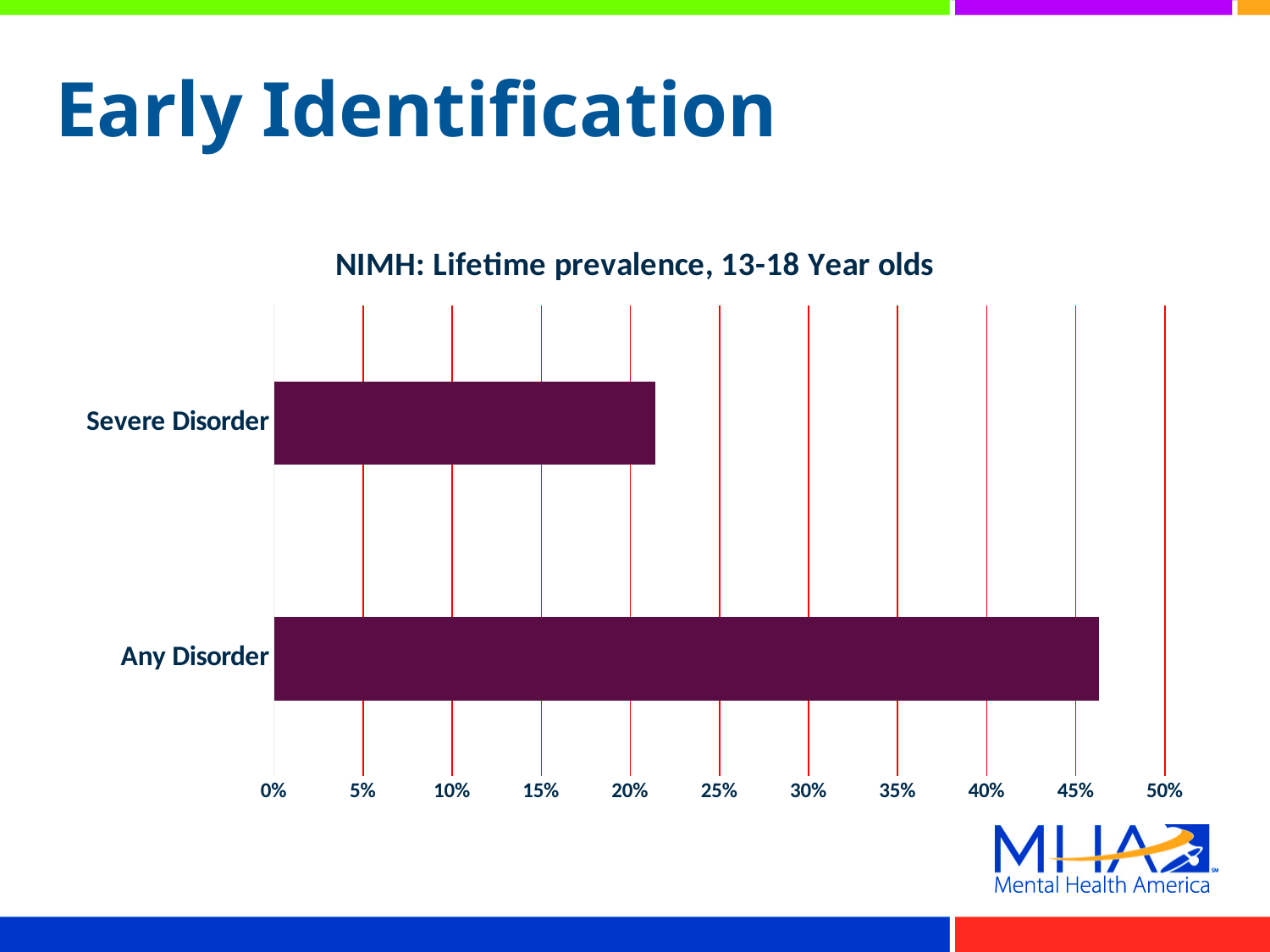
What is the title of the chart? NIMH: Lifetime prevalence, 13-18 Year olds Is the value for Severe Disorder greater or less than 20%? greater Which category has the highest value? Any Disorder Which is larger, the value for Any Disorder or the value for Severe Disorder? Any Disorder Which category has the lowest value? Severe Disorder Is the value for Severe Disorder greater or less than 25%? less What is the highest value shown on the horizontal axis? 50% What kind of chart is shown on the slide? bar chart Is the value for Any Disorder greater or less than 45%? greater How many categories are plotted in the chart? 2